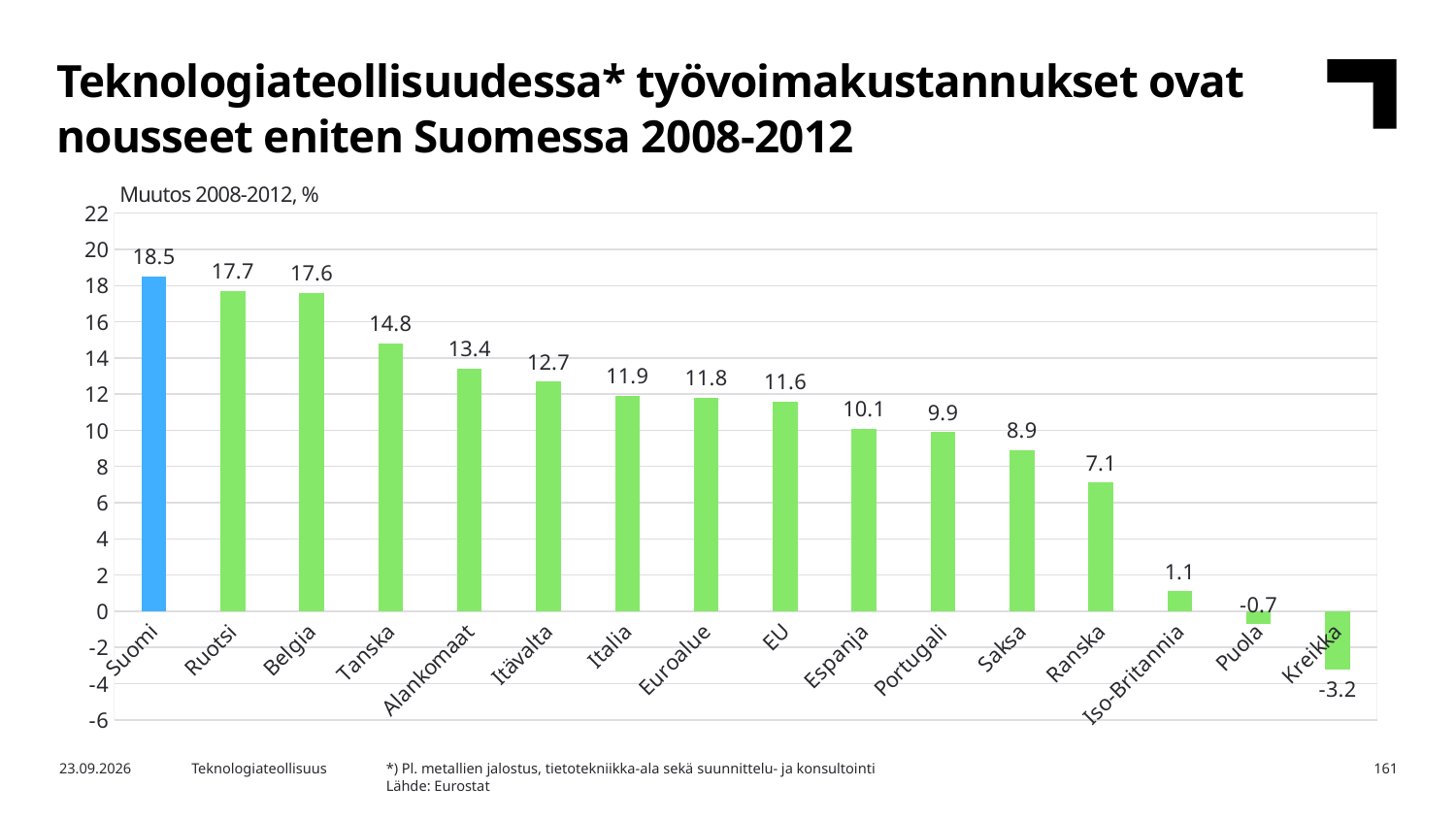
Do the values rise or fall from left to right along the x axis? Fall What kind of chart is shown on the slide? Bar chart What is the value for Iso-Britannia? 1.1 Which country has the highest value? Suomi How many categories are shown on the x axis? 16 Which category has the lowest value? Kreikka What is the value for Alankomaat? 13.4 What is the difference between the values for Suomi and Ruotsi? 0.8 What is the value for Kreikka? -3.2 What is the difference between the values for Tanska and Saksa? 5.9 What is the value for Suomi? 18.5 Which is larger, the value for Espanja or the value for Portugali? Espanja